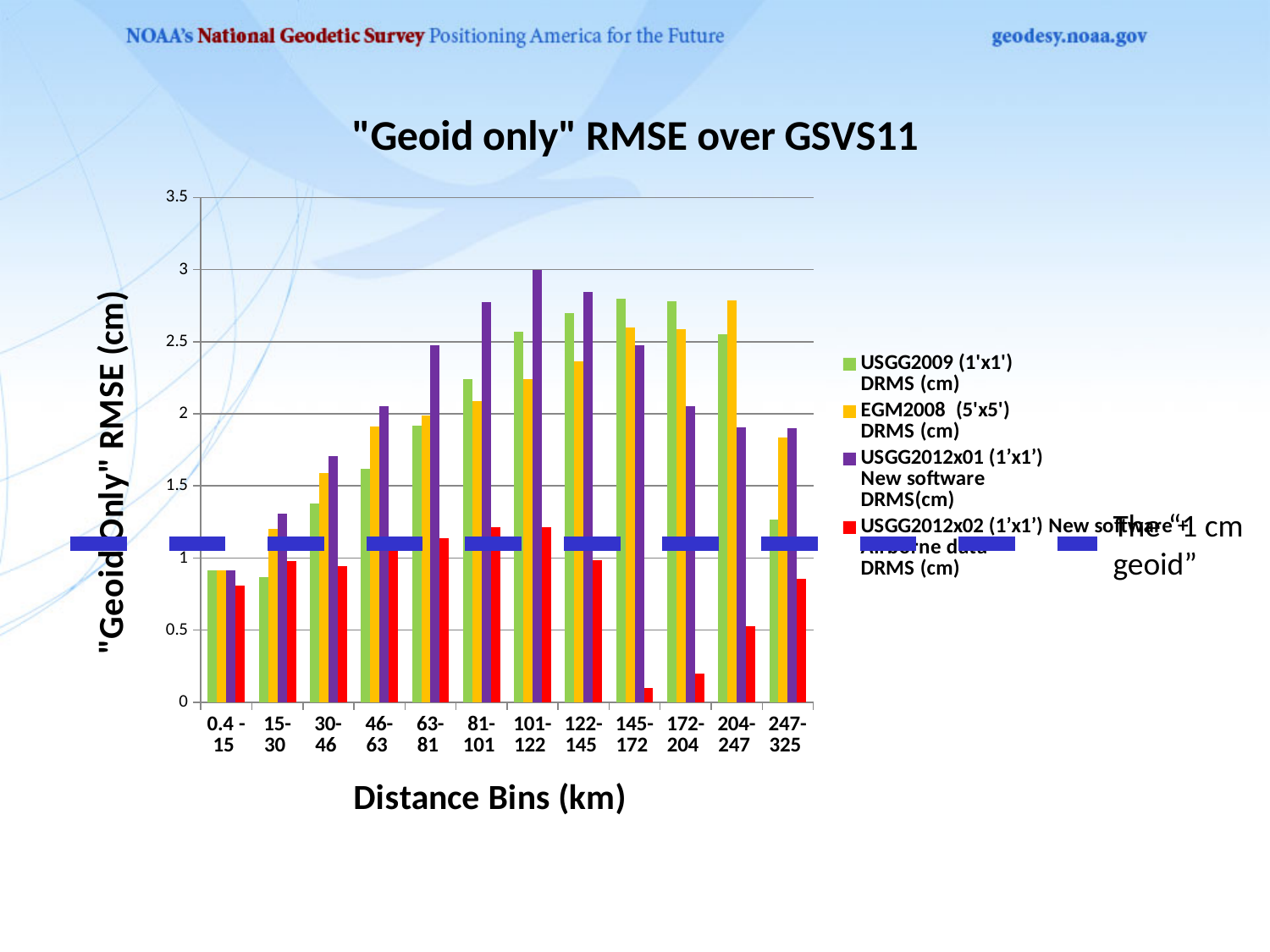
Is the USGG2012x01 value for the 101-122 km bin greater or less than 2.5? greater How many distance bins are shown on the x axis? 12 In the 204-247 km bin, which is larger: the EGM2008 value or the USGG2012x01 value? EGM2008 Does the USGG2012x02 series rise or fall from the 101-122 km bin to the 145-172 km bin? fall Is the USGG2009 value for the 145-172 km bin greater or less than 2.5? greater For the USGG2012x02 (1'x1') New software + Airborne data DRMS series, which distance bin has the lowest value? 145-172 In the 63-81 km bin, which is larger: the USGG2009 value or the USGG2012x01 value? USGG2012x01 What is the title of the x axis? Distance Bins (km) How many series does the legend list? 4 Is the USGG2012x02 value for the 145-172 km bin greater or less than 0.5? less What kind of chart is shown on the slide? bar chart For the USGG2012x01 (1'x1') New software DRMS series, which distance bin has the highest value? 101-122